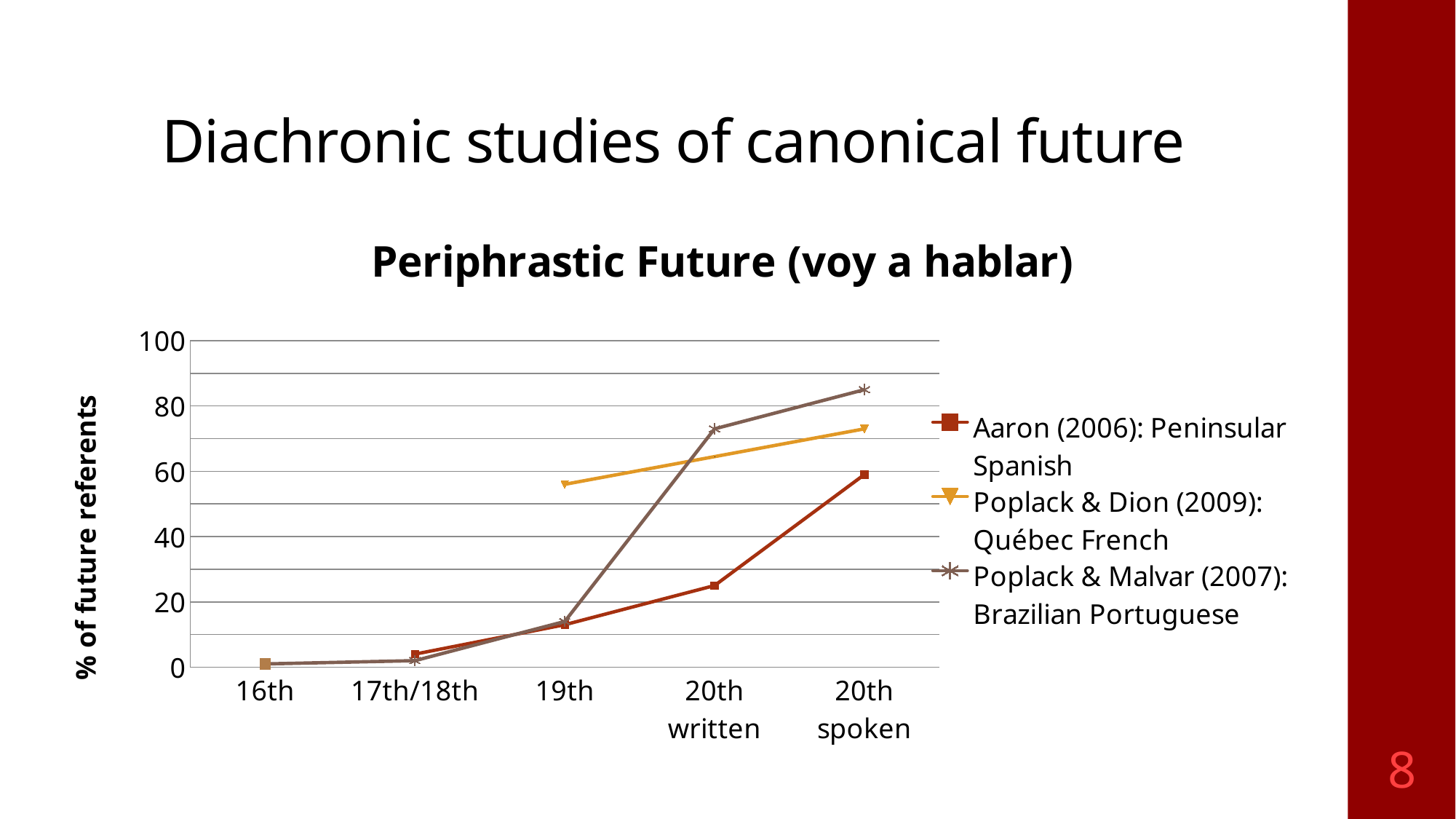
What kind of chart is shown on the slide? line chart Is the value for Poplack & Dion (2009): Québec French at 19th greater or less than 40? greater What is the title of the chart? Periphrastic Future (voy a hablar) Is the value for Poplack & Malvar (2007): Brazilian Portuguese at 20th spoken greater or less than 80? greater At 20th written, which series has the higher value: Aaron (2006): Peninsular Spanish or Poplack & Malvar (2007): Brazilian Portuguese? Poplack & Malvar (2007): Brazilian Portuguese Does the Aaron (2006): Peninsular Spanish series rise or fall from 16th to 20th spoken? rise Which series reaches the highest value at 20th spoken? Poplack & Malvar (2007): Brazilian Portuguese How many categories are shown along the x axis? 5 How many series does the legend list? 3 Is the value for Aaron (2006): Peninsular Spanish at 20th spoken greater or less than 40? greater At 20th spoken, which series has the higher value: Aaron (2006): Peninsular Spanish or Poplack & Malvar (2007): Brazilian Portuguese? Poplack & Malvar (2007): Brazilian Portuguese